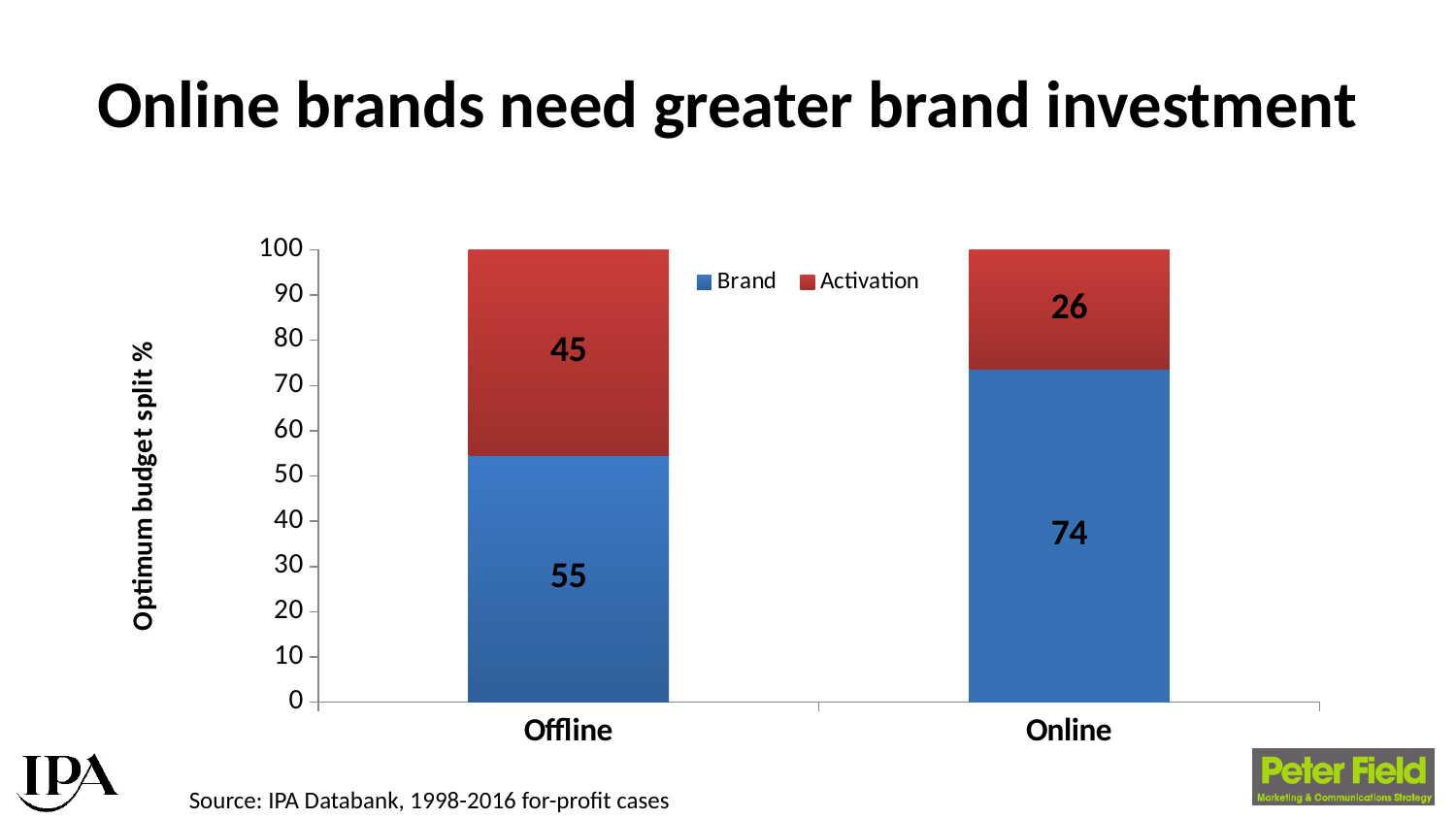
What is the Activation value for Offline? 45 Which category has the lowest Activation value? Online What is the Activation value for Online? 26 Which category has the higher Brand value, Offline or Online? Online How many series does the legend list? 2 What is the Brand value for Online? 74 What is the difference between the Brand values for Online and Offline? 19 What is the total of the stacked bar for Offline? 100 What is the Brand value for Offline? 55 How many categories are shown on the x axis? 2 What is the label of the y axis? Optimum budget split % What kind of chart is shown on the slide? Stacked bar chart